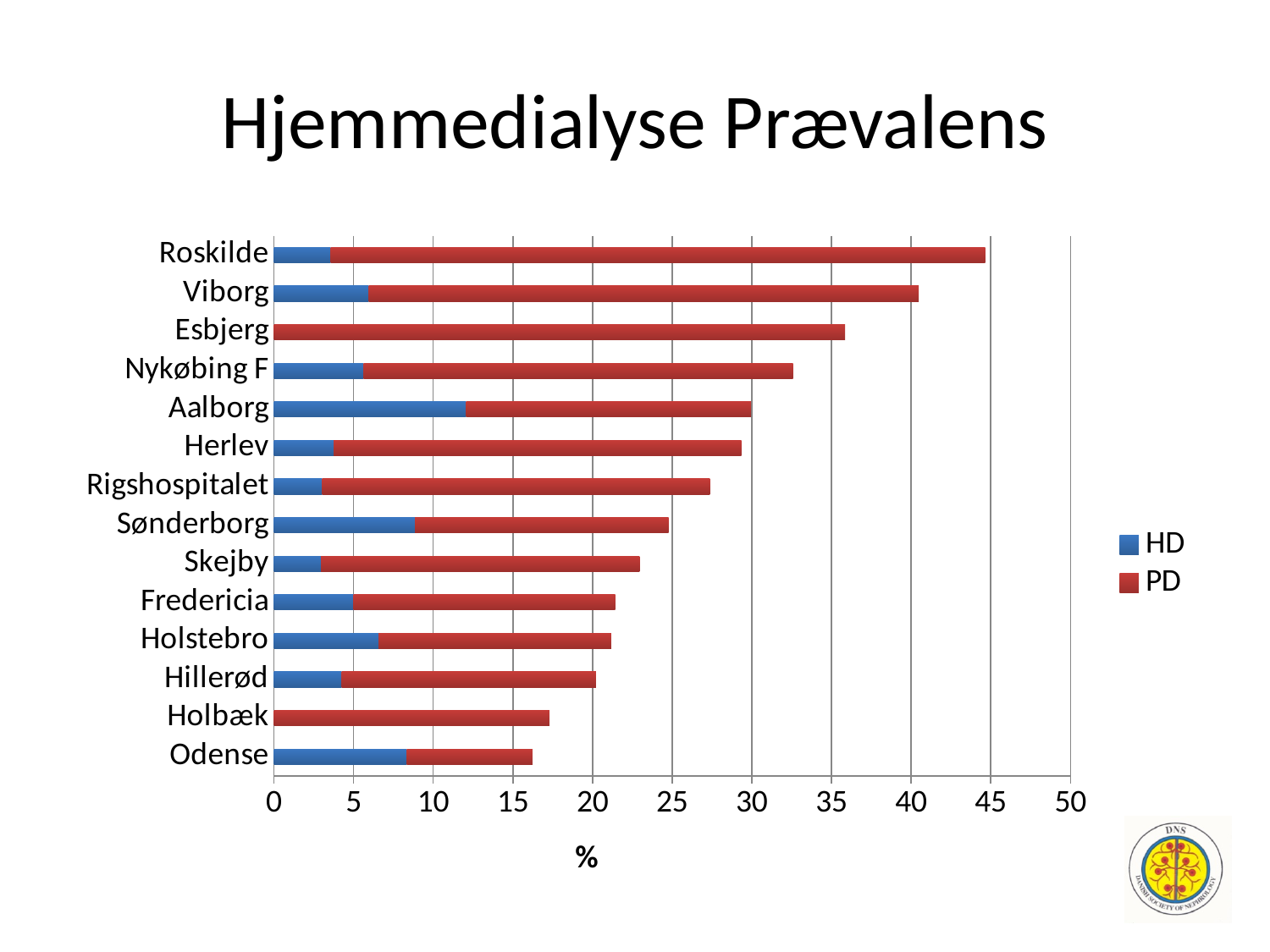
Is the total value for Rigshospitalet greater or less than 30? less What is the label on the x axis? % How many centres (categories) are plotted on the chart? 14 Is the total value for Nykøbing F greater or less than 30? greater Is the HD value for Aalborg greater or less than 10? greater Which centre has the highest total home dialysis prevalence? Roskilde Which has the larger total value, Roskilde or Viborg? Roskilde Which centre has the largest HD segment? Aalborg What kind of chart is shown on the slide? bar chart How many series does the legend list? 2